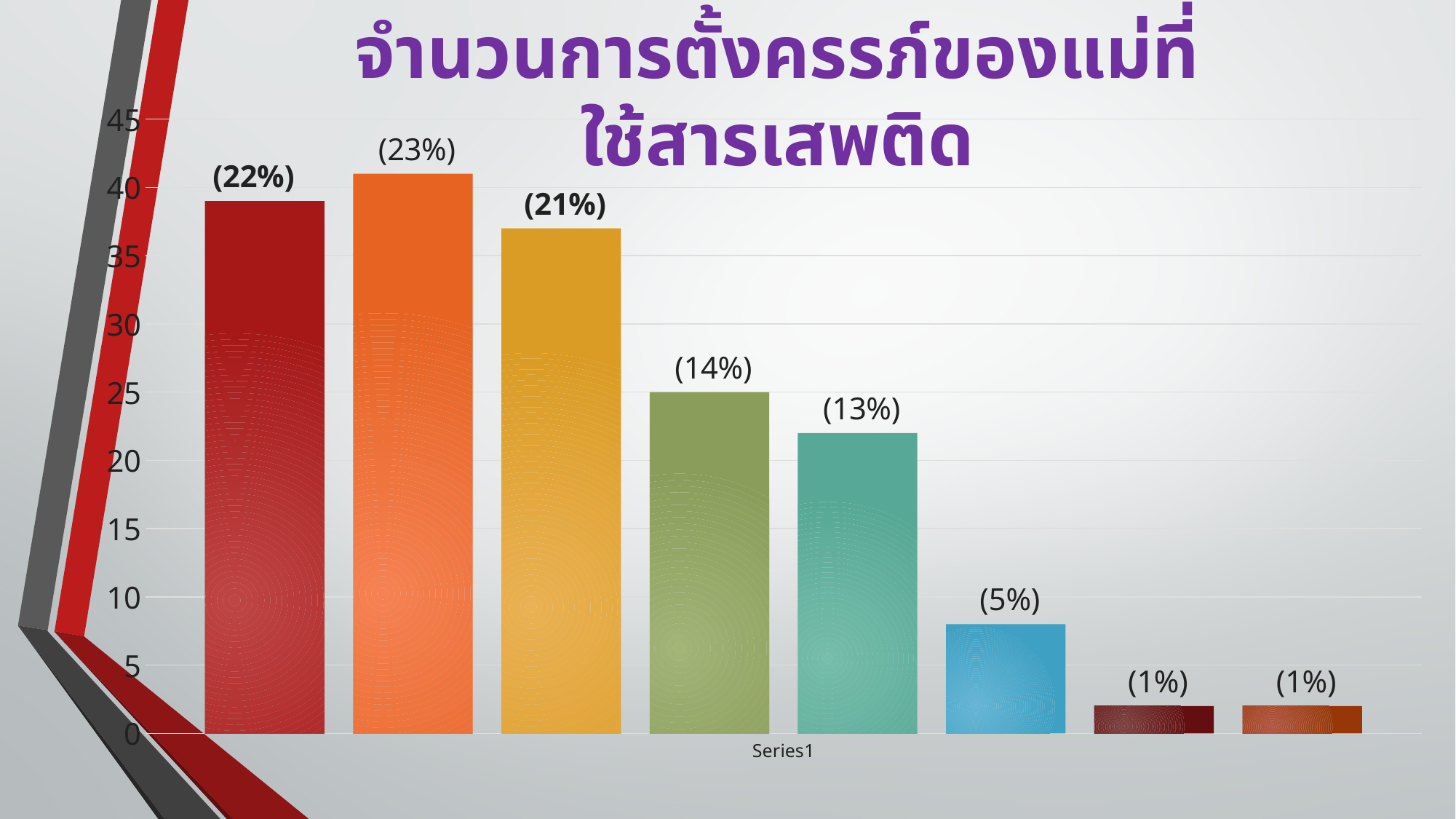
Which bar has the highest percentage label? the second (orange) bar, (23%) What is the data label on the light blue bar (sixth from the left)? (5%) What is the data label on the second (orange) bar from the left? (23%) What is the data label on the first (dark red) bar from the left? (22%) What kind of chart is shown on the slide? bar chart Is the value of the first (dark red) bar greater or less than 35? greater Is the value of the light blue bar (sixth from the left) greater or less than 10? less What is the difference between the percentage labels of the second bar (23%) and the first bar (22%)? 1% Which is larger, the fourth (green) bar or the fifth (teal) bar? the fourth (green) bar How many bars are plotted in the chart? 8 Is the value of the fourth (green) bar greater or less than 20? greater What label appears under the x axis of the chart? Series1